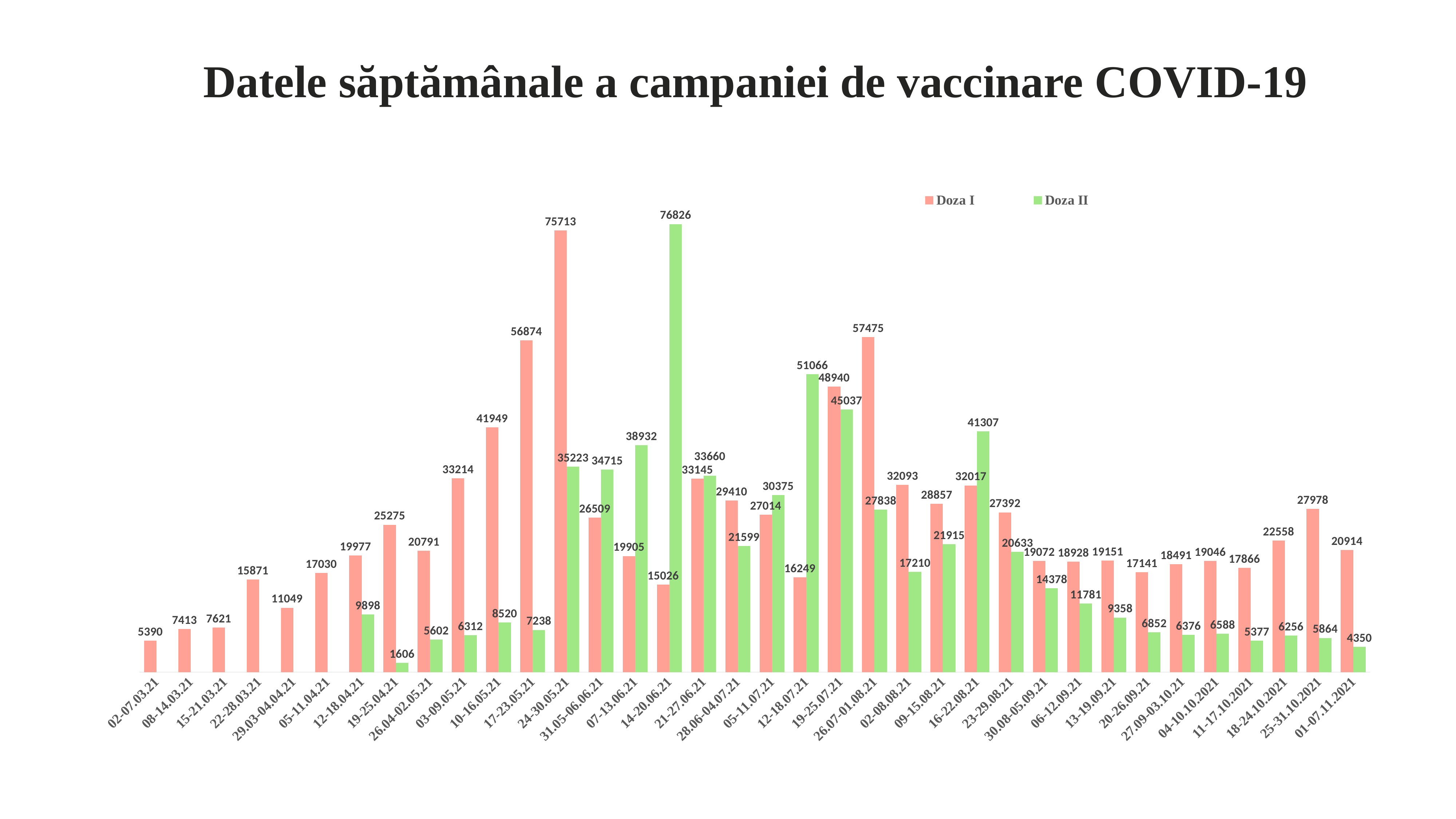
What is the title of the chart? Datele săptămânale a campaniei de vaccinare COVID-19 For the week 12-18.07.21, which is larger, Doza I or Doza II? Doza II How many series does the legend list? 2 What is the Doza I value for the week 01-07.11.2021? 20914 Which week has the lowest Doza I value? 02-07.03.21 What is the Doza I value for the week 24-30.05.21? 75713 What is the difference between the Doza I and Doza II values for the week 26.07-01.08.21? 29637 What is the Doza II value for the week 14-20.06.21? 76826 What type of chart is shown on the slide? bar chart Which week has the lowest Doza II value? 19-25.04.21 Does the Doza I value rise or fall from the week 02-07.03.21 to the week 24-30.05.21? rise Which week has the highest Doza II value? 14-20.06.21